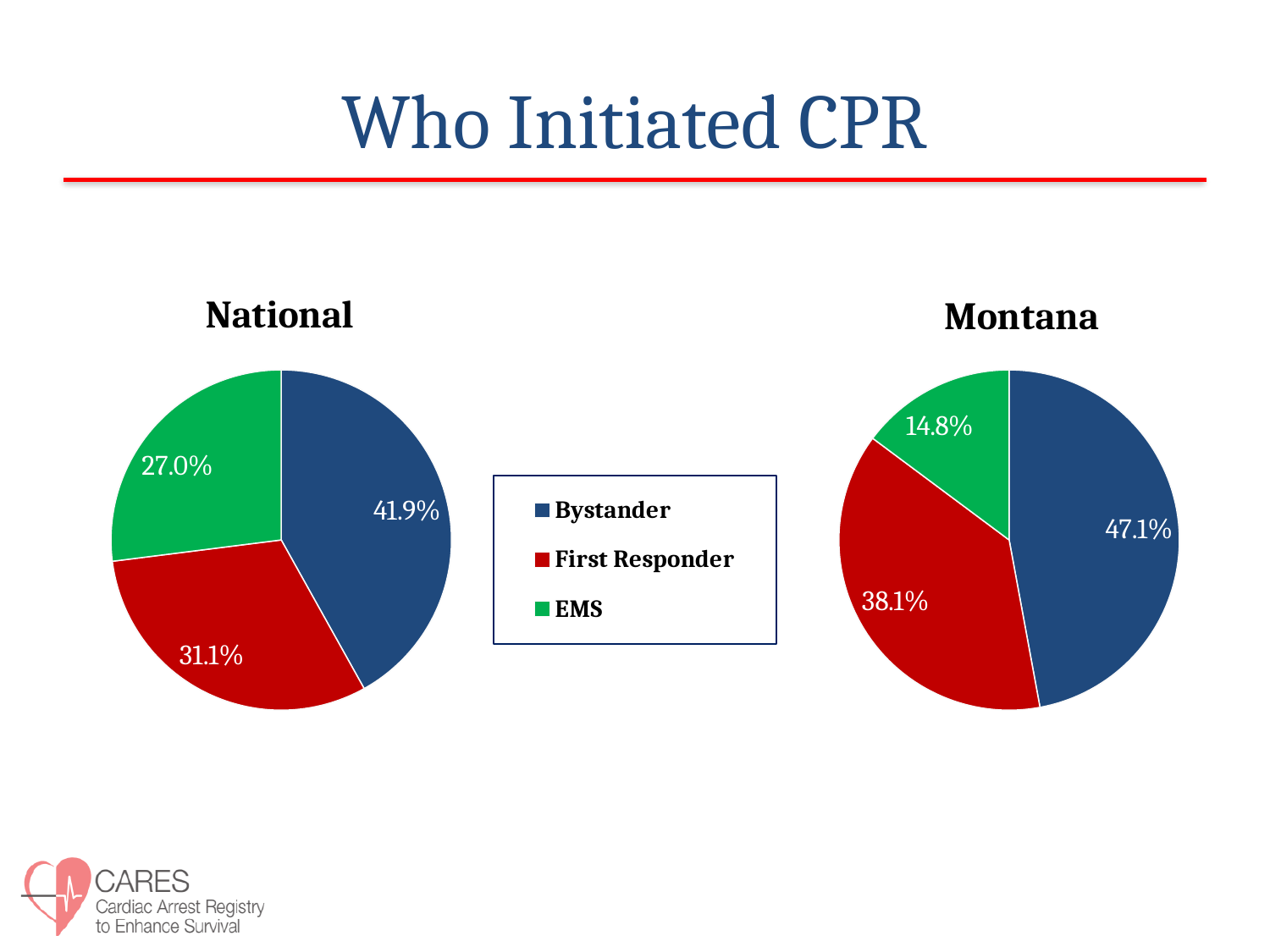
How many slices does the National pie chart have? 3 Which colour represents First Responder in the legend? Red Is the Bystander share larger in the National chart or the Montana chart? Montana In the Montana pie chart, what is the value for First Responder? 38.1% What type of chart is used to show the Montana data? Pie chart In the Montana pie chart, what is the difference between the First Responder and EMS shares? 23.3% In the National pie chart, what percentage of CPR was initiated by a Bystander? 41.9% In the National pie chart, which category has the largest share? Bystander In the Montana pie chart, which category has the smallest share? EMS In the Montana pie chart, what percentage of CPR was initiated by EMS? 14.8% In the National pie chart, what is the value for EMS? 27.0% In the National pie chart, what is the difference between the Bystander and First Responder shares? 10.8%